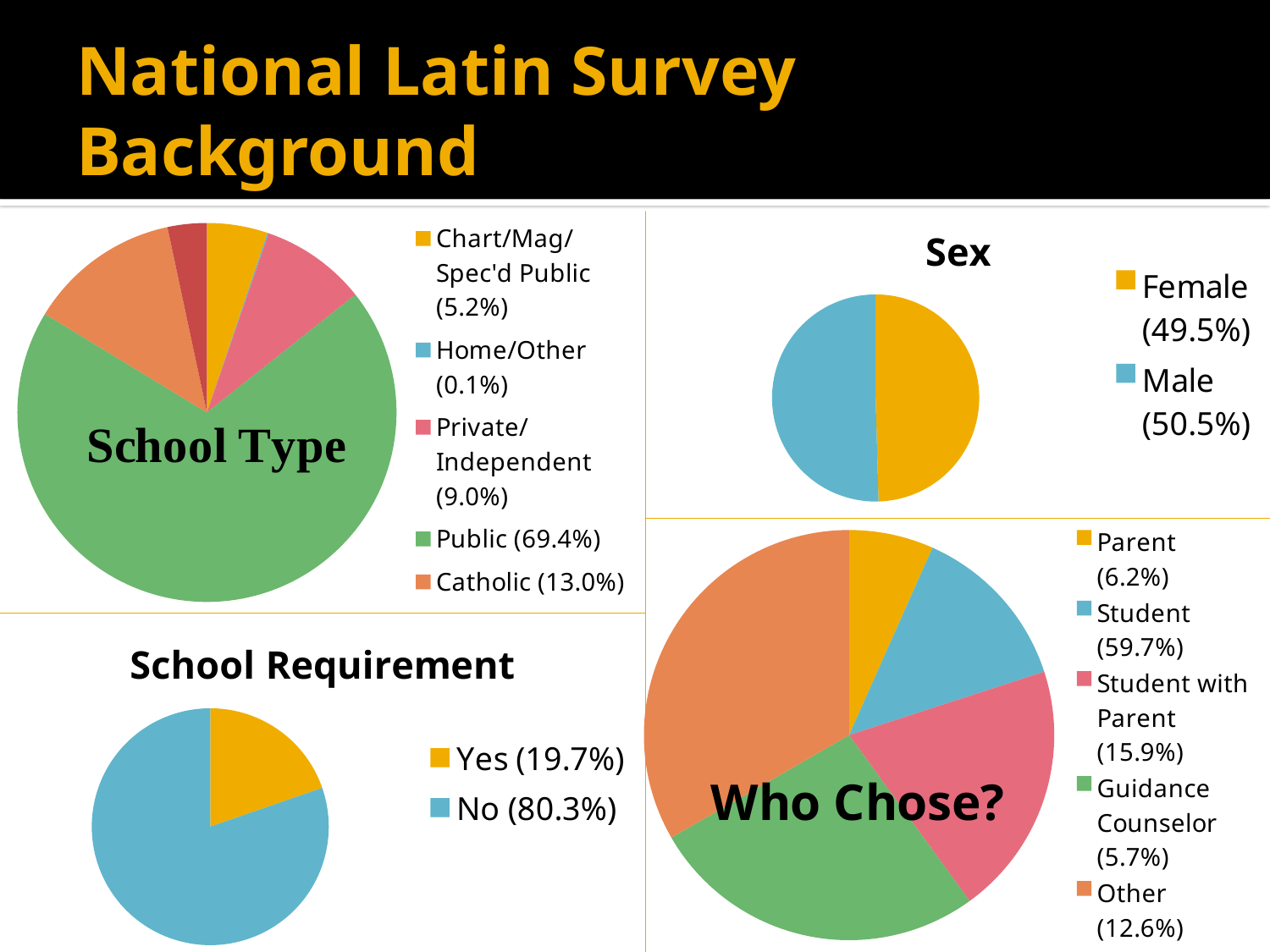
In the Who Chose? chart, what percentage is listed for Guidance Counselor? 5.7% In the Who Chose? chart, what percentage is listed for Student with Parent? 15.9% In the School Type chart, which school type has the largest share? Public In the School Type chart, which school type has the smallest share? Home/Other What kind of chart is the School Requirement chart? Pie chart In the School Type chart, what percentage of respondents attend Public schools? 69.4% In the Sex chart, what percentage of respondents are Male? 50.5% In the School Type chart, what percentage is Catholic? 13.0% In the School Requirement chart, which answer is larger, Yes or No? No In the Sex chart, what is the difference between the Male and Female percentages? 1.0% In the School Requirement chart, what percentage answered No? 80.3% In the School Type chart, how many school type categories does the legend list? 5